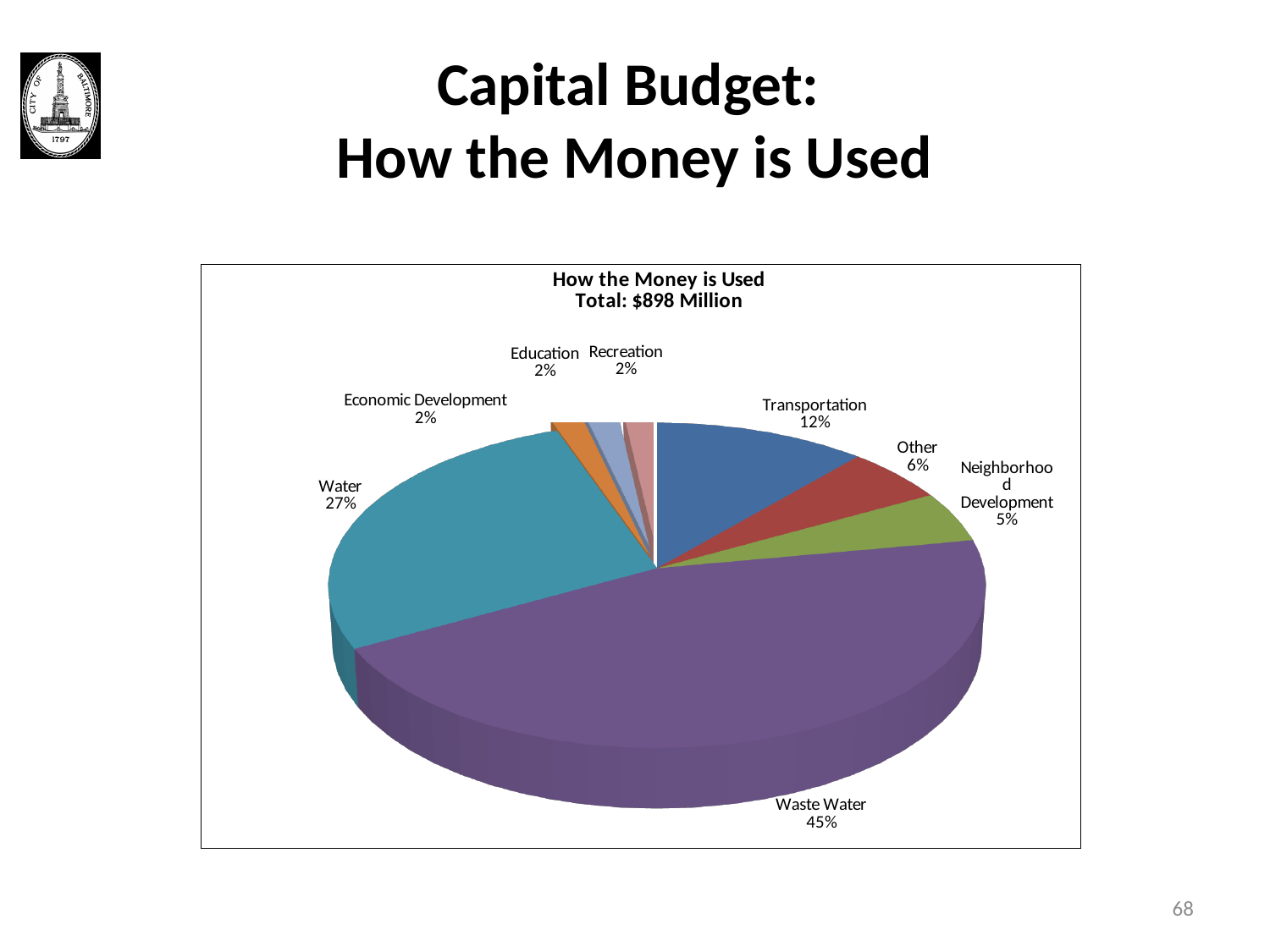
What share of the money is used for Water? 27% What percentage is shown for Transportation? 12% Which category has the largest share of the pie? Waste Water What percentage is shown for Economic Development? 2% How many categories are shown in the pie chart? 8 What total amount is stated in the chart title? $898 Million What kind of chart is shown on the slide? Pie chart Which is larger, the share for Other or the share for Neighborhood Development? Other What percentage is shown for Neighborhood Development? 5% What is the combined share of Transportation and Other? 18% What share of the money is used for Waste Water? 45% What is the difference in percentage points between Waste Water and Water? 18